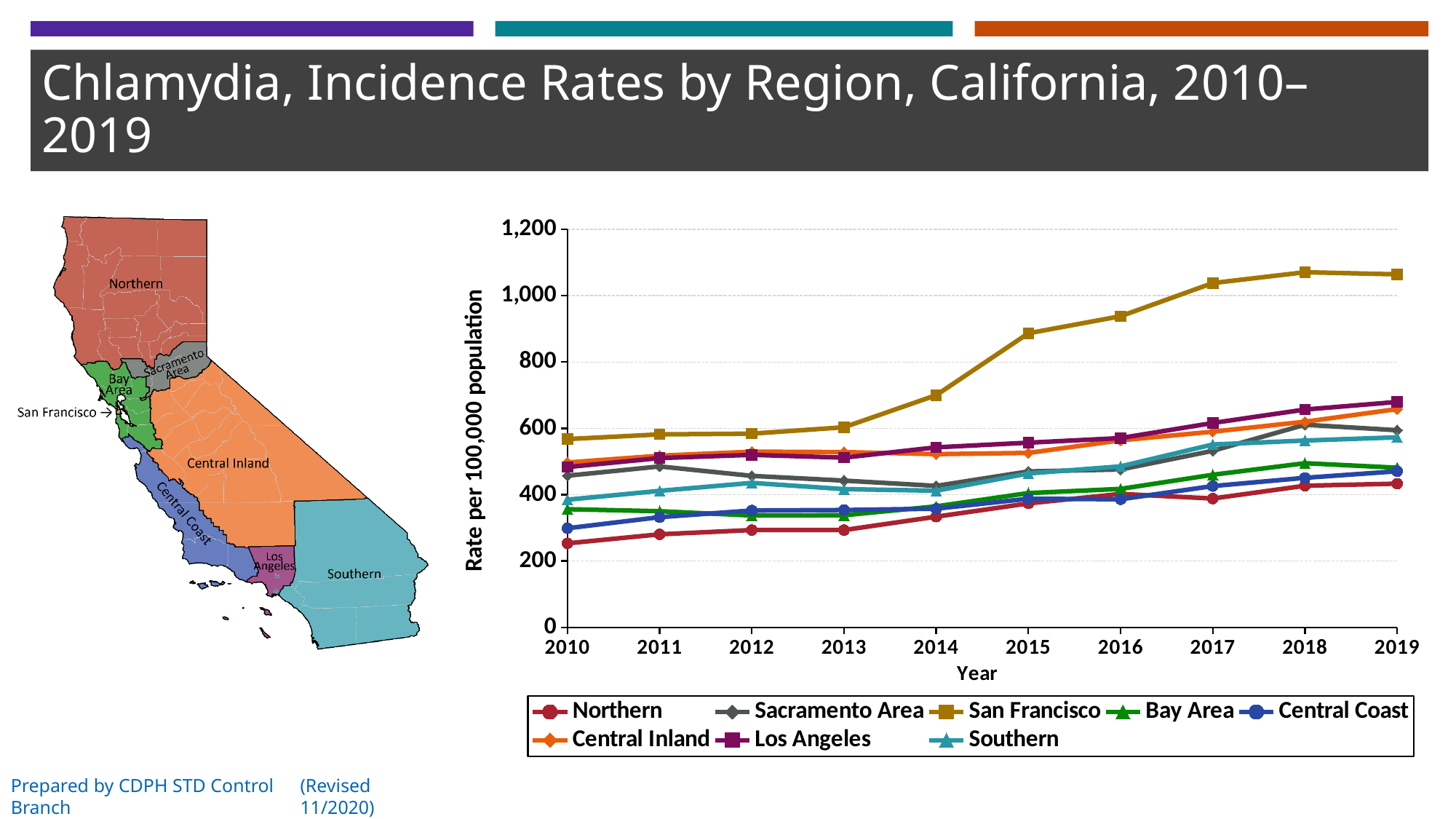
What is the label of the x axis? Year Does the San Francisco rate rise or fall from 2010 to 2019? rise Is the value for Southern in 2019 greater or less than 400? greater Is the value for San Francisco in 2018 greater or less than 1,000? greater Which region has the lowest chlamydia incidence rate in 2010? Northern In 2019, which is larger: the rate for Los Angeles or the rate for Bay Area? Los Angeles How many regions (series) does the legend list? 8 What kind of chart is shown on the slide? line chart How many years are plotted along the x axis? 10 Which region has the highest chlamydia incidence rate in 2019? San Francisco Is the value for Northern in 2010 greater or less than 400? less What is the label of the y axis? Rate per 100,000 population